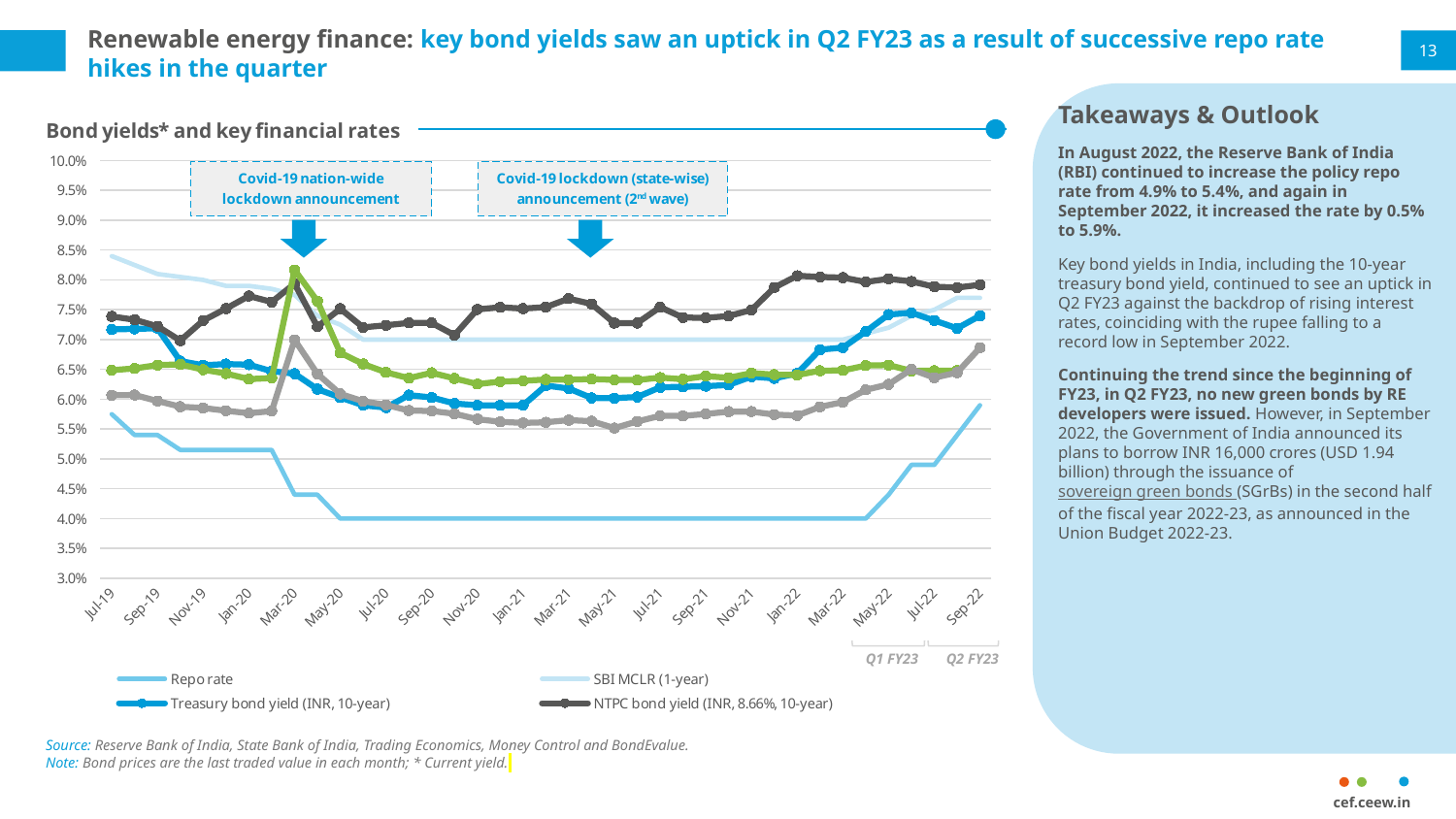
Is the SBI MCLR (1-year) in Jul-19 greater or less than 8.0%? greater Does the repo rate rise or fall between Mar-22 and Sep-22? Rise What kind of chart is shown on the slide? Line chart Does the repo rate rise or fall between Jul-19 and May-20? Fall What is the title of the chart on the slide? Bond yields* and key financial rates Which series has the highest value in Jul-19? SBI MCLR (1-year) What value does the repo rate line sit at from mid-2020 through early 2022? 4.0% In Sep-22, which is higher: the NTPC bond yield (INR, 8.66%, 10-year) or the Treasury bond yield (INR, 10-year)? NTPC bond yield (INR, 8.66%, 10-year) How many series does the chart's legend list? 4 Is the Treasury bond yield (INR, 10-year) in Jul-19 greater or less than 7.5%? less Which series has the lowest value in Jul-19? Repo rate Is the NTPC bond yield (INR, 8.66%, 10-year) in Sep-22 greater or less than 7.5%? greater